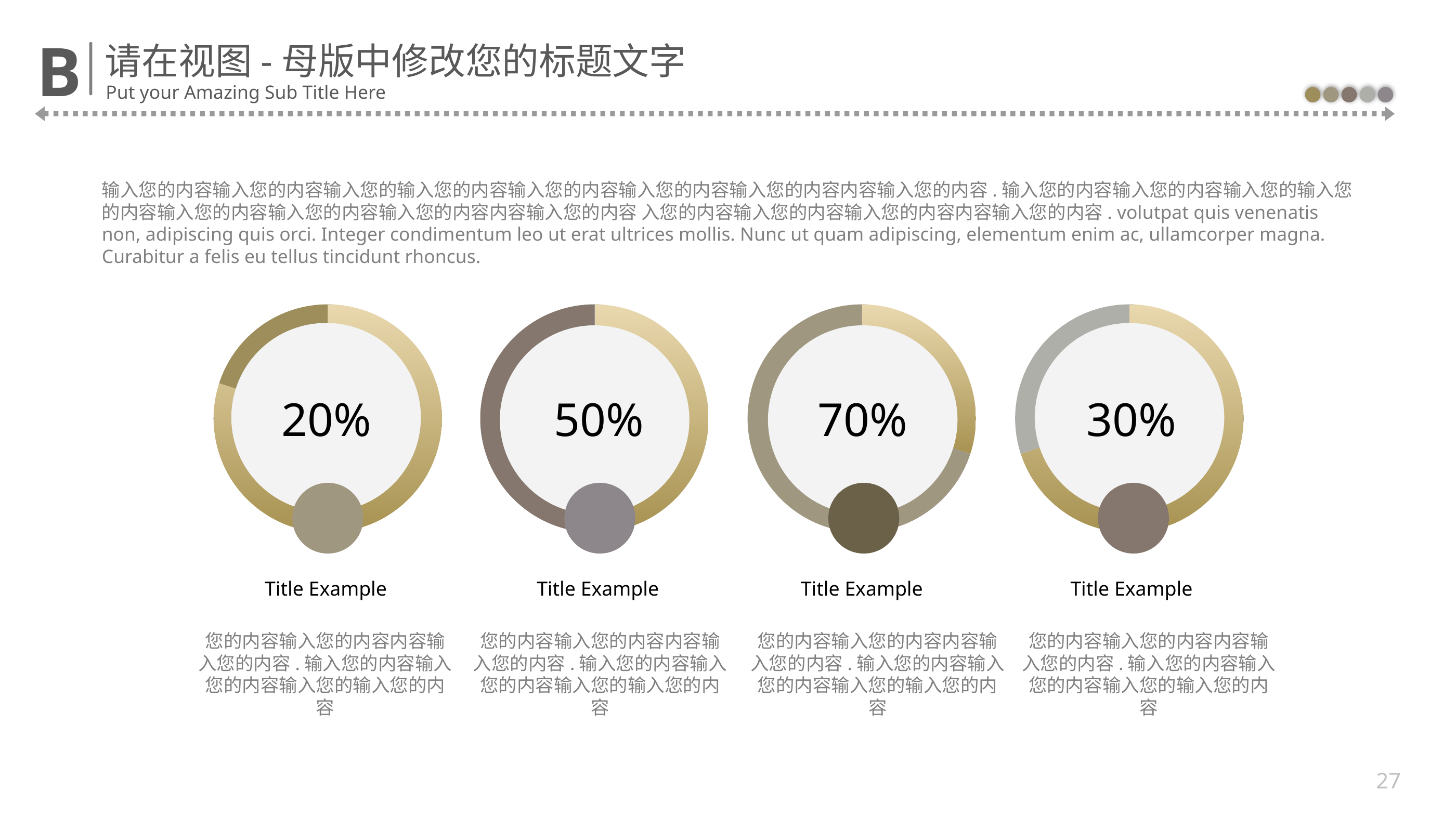
What kind of chart is used to display the percentages on the slide? Ring (donut) chart Which of the four ring charts shows the lowest percentage? The leftmost (20%) What value is shown in the second ring chart from the left? 50% Which of the four ring charts shows the highest percentage? The third from the left (70%) What value is shown in the rightmost ring chart? 30% How many ring charts are shown on the slide? 4 What value is shown in the leftmost ring chart? 20% Which is larger: the value in the second ring chart or the value in the rightmost ring chart? The second ring chart (50%) What is the difference between the value in the second ring chart (50%) and the value in the rightmost ring chart (30%)? 20% What label appears beneath each of the four ring charts? Title Example What value is shown in the third ring chart from the left? 70% What is the difference between the value in the third ring chart (70%) and the value in the leftmost ring chart (20%)? 50%